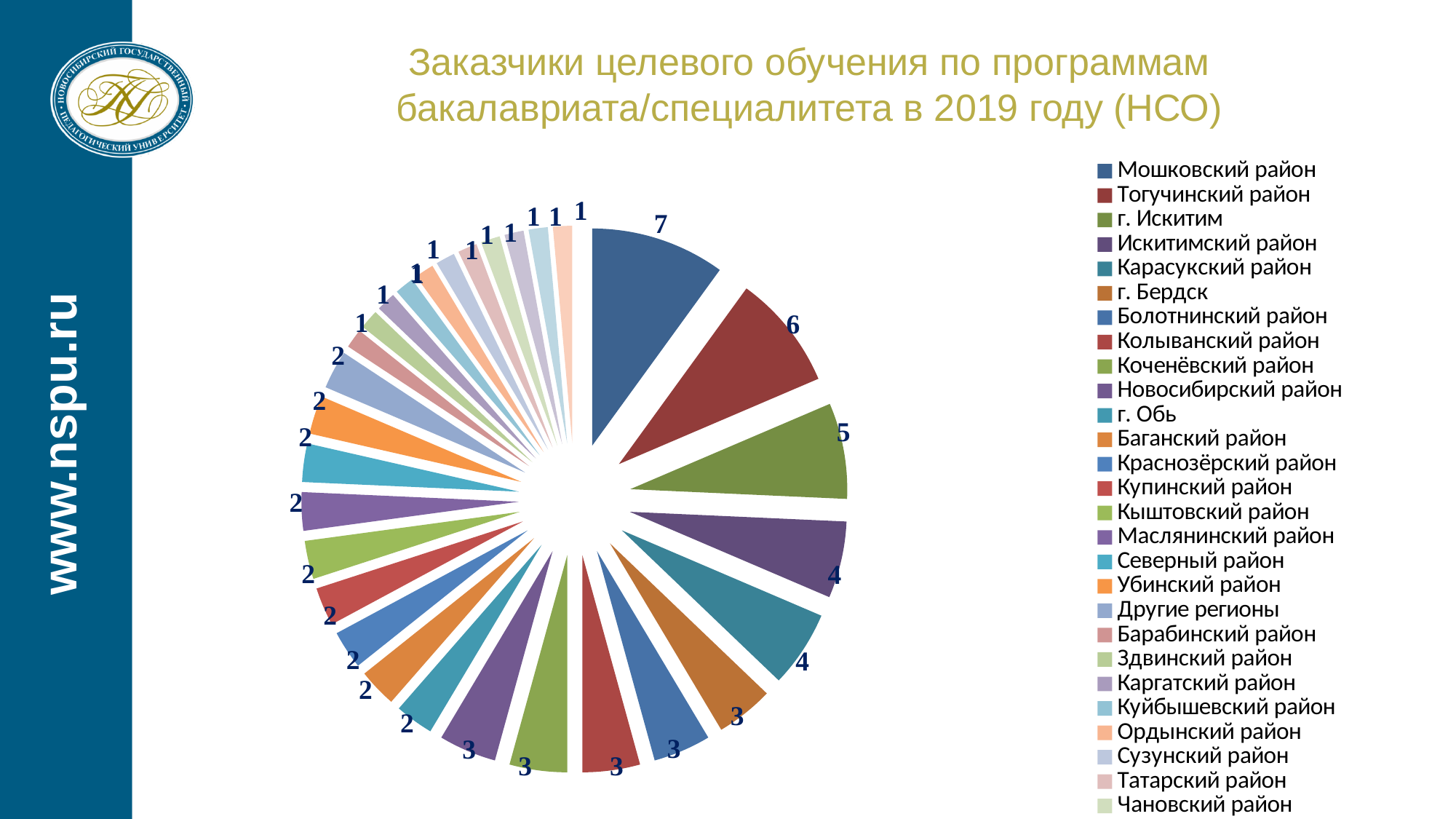
What is the title of the chart? Заказчики целевого обучения по программам бакалавриата/специалитета в 2019 году (НСО) Which category has the largest slice in the pie chart? Мошковский район What is the value for г. Искитим? 5 What is the value for Искитимский район? 4 What is the difference between the values for Мошковский район and г. Искитим? 2 What is the difference between the values for Мошковский район and Тогучинский район? 1 What is the value for Мошковский район? 7 What kind of chart is shown on the slide? pie chart Which is larger, the value for Тогучинский район or the value for Искитимский район? Тогучинский район What is the value for Тогучинский район? 6 What is the value for г. Бердск? 3 Which category is listed first in the legend? Мошковский район